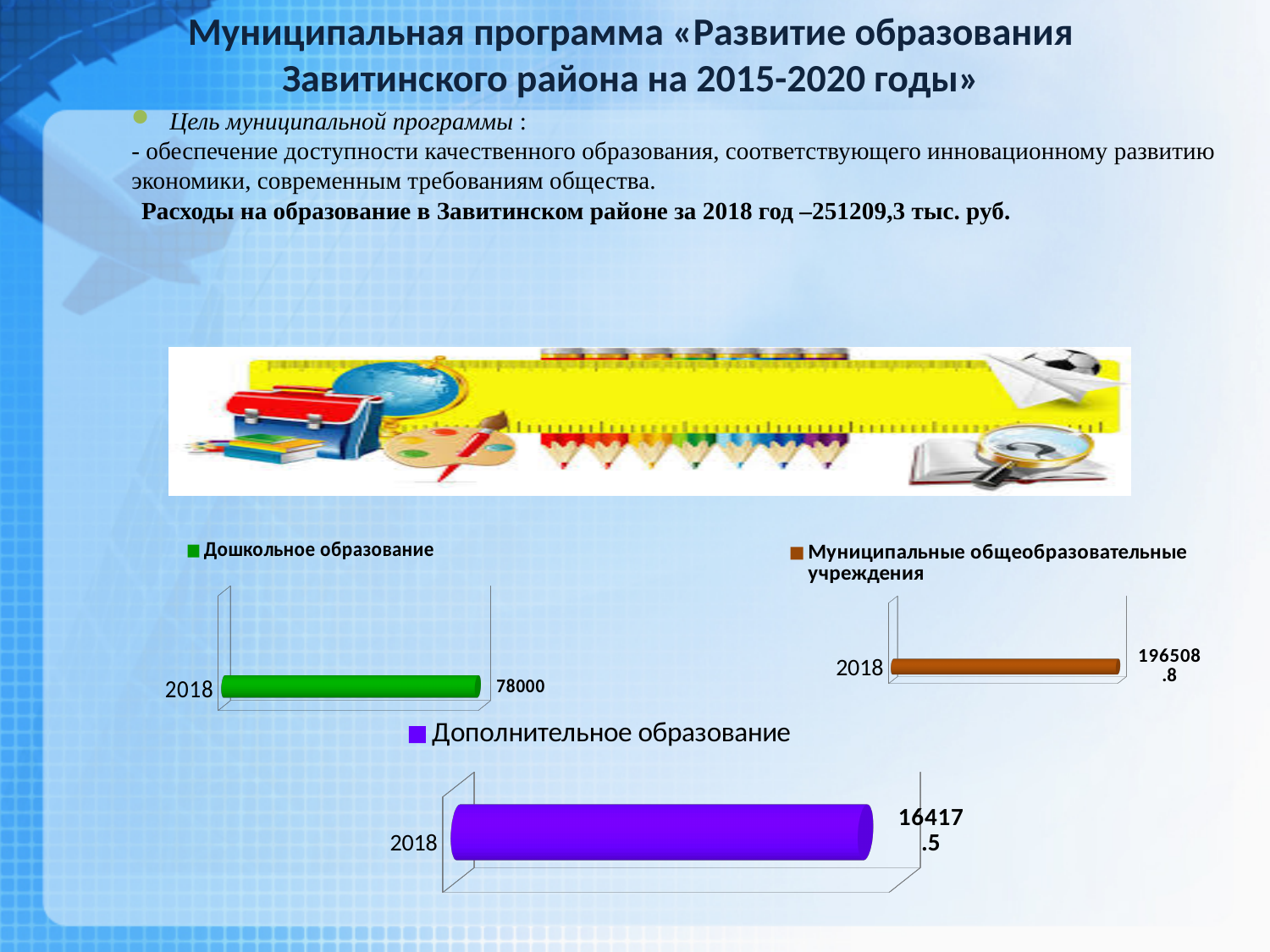
What is the difference between the 2018 value in the "Муниципальные общеобразовательные учреждения" chart and the 2018 value in the "Дошкольное образование" chart? 118508.8 How many categories are plotted in the "Дополнительное образование" chart? 1 In the chart with legend "Дополнительное образование", what is the value for 2018? 16417.5 In the chart with legend "Муниципальные общеобразовательные учреждения", what is the value for 2018? 196508.8 What category label appears on the axis of the "Дополнительное образование" chart? 2018 In the chart with legend "Дошкольное образование", what is the value for 2018? 78000 Which is larger: the 2018 value in the "Дошкольное образование" chart or the 2018 value in the "Дополнительное образование" chart? Дошкольное образование How many series does the legend of the "Муниципальные общеобразовательные учреждения" chart list? 1 What colour is the bar in the "Дополнительное образование" chart? purple What kind of chart is the "Дошкольное образование" chart? bar chart How many charts are shown on the slide? 3 What is the difference between the 2018 value in the "Дошкольное образование" chart and the 2018 value in the "Дополнительное образование" chart? 61582.5